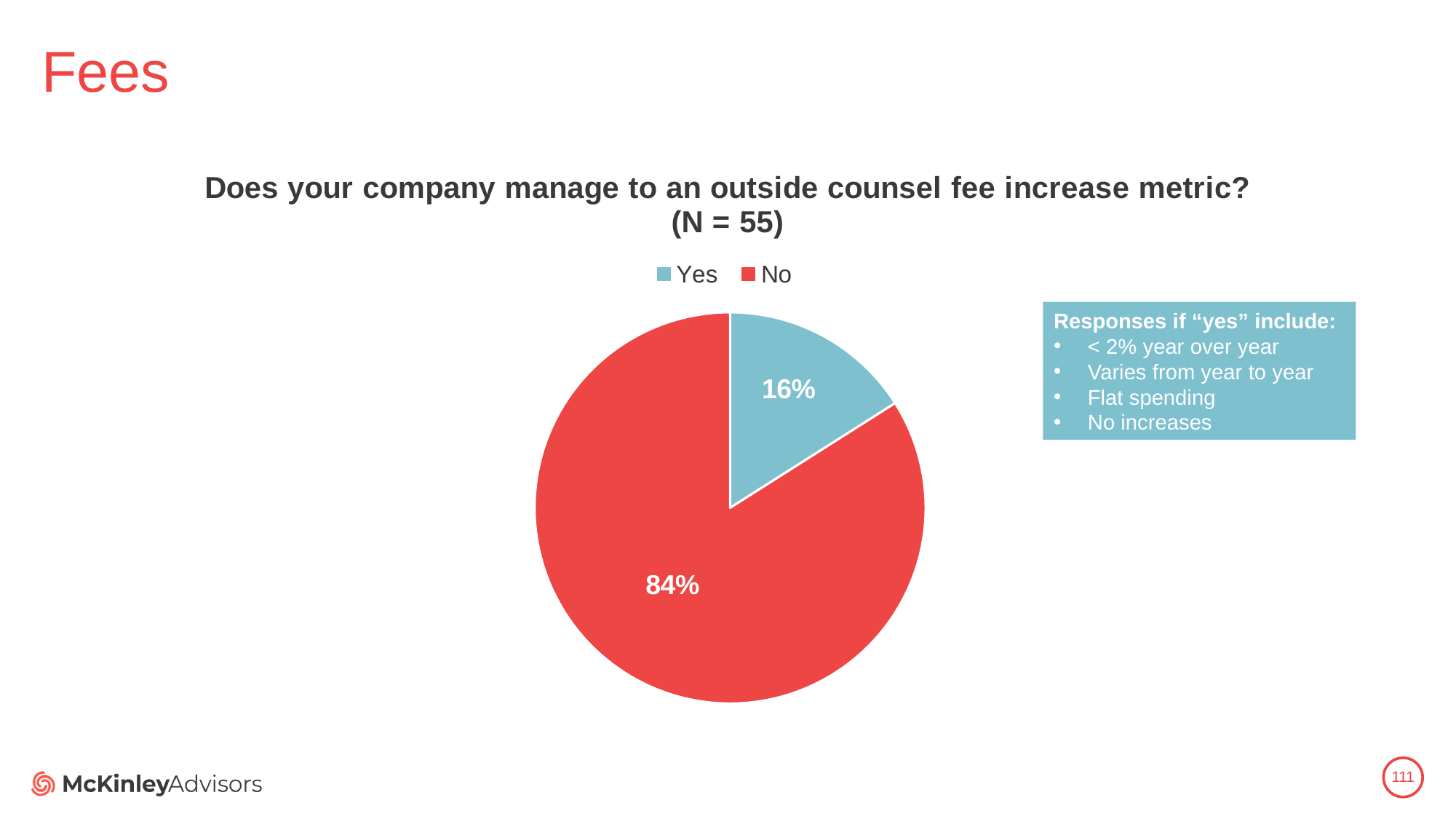
How many slices does the pie chart have? 2 How many entries does the legend list? 2 Which response has the smallest slice of the pie? Yes Which response has the largest slice of the pie? No What colour is the "No" slice of the pie? red What is the sample size (N) stated in the chart title? 55 What share of respondents answered "Yes"? 16% Which is larger, the "Yes" slice or the "No" slice? No What share of respondents answered "No"? 84% What kind of chart is shown on the slide? pie chart What is the difference in percentage points between the "No" and "Yes" slices? 68